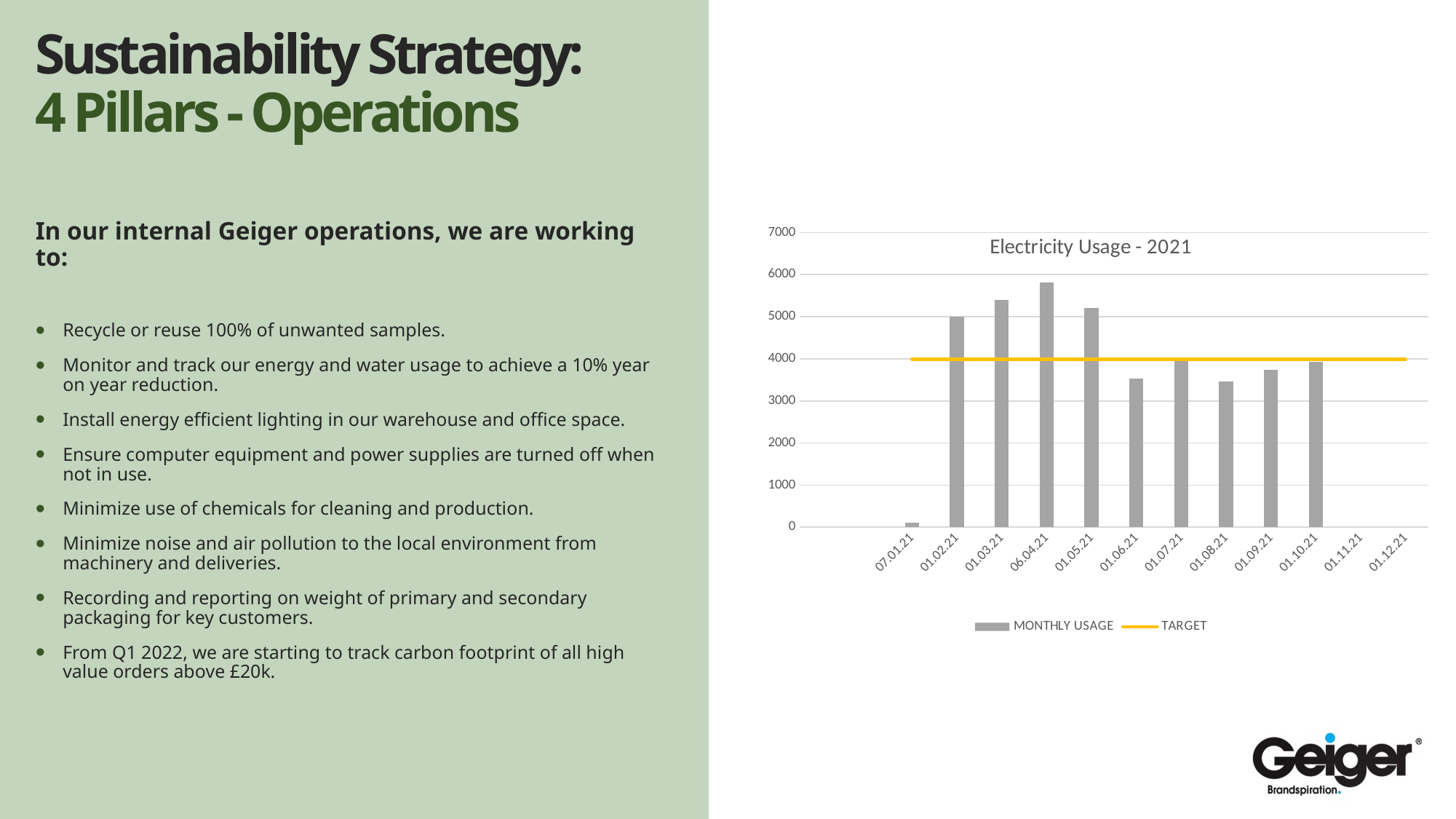
Which date has the highest monthly usage bar? 06.04.21 Which has the larger monthly usage, 01.02.21 or 01.08.21? 01.02.21 Which date has the lowest monthly usage bar? 07.01.21 What kind of chart is used to show the monthly electricity usage? bar chart What are the two series named in the chart legend? MONTHLY USAGE and TARGET Is the monthly usage for 01.02.21 greater or less than 4000? greater Is the monthly usage for 06.04.21 greater or less than 5000? greater What is the title of the chart on the slide? Electricity Usage - 2021 How many dates are shown on the x axis of the chart? 12 Is the monthly usage for 01.06.21 greater or less than 4000? less How many series does the chart legend list? 2